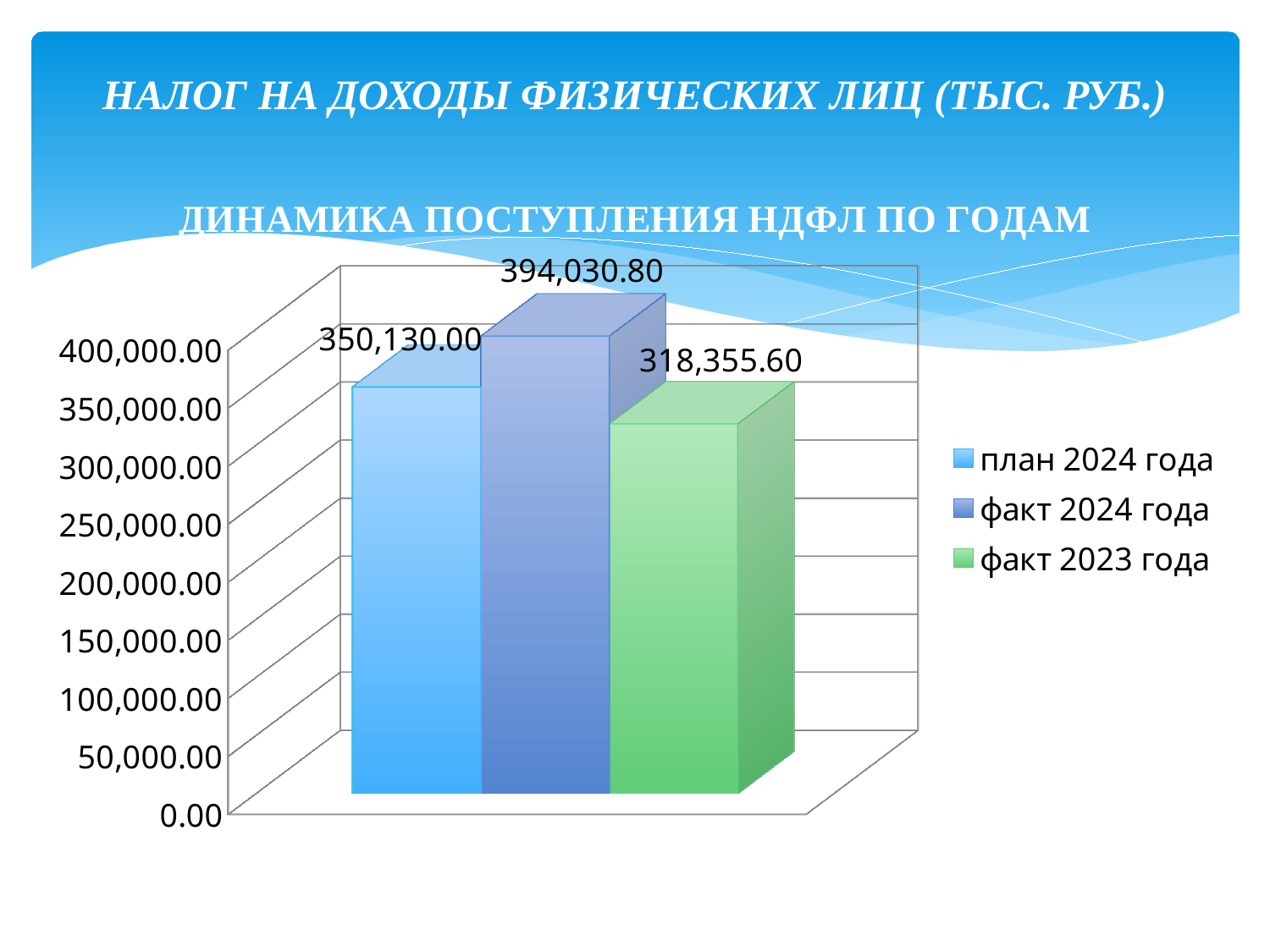
What is the difference between факт 2024 года and план 2024 года? 43,900.80 What is the value for факт 2023 года? 318,355.60 What is the value for план 2024 года? 350,130.00 What kind of chart is shown on the slide? bar chart Which series has the highest value? факт 2024 года Which series has the lowest value? факт 2023 года Is the value for факт 2023 года greater or less than 300,000.00? greater What is the difference between факт 2024 года and факт 2023 года? 75,675.20 Which is larger, план 2024 года or факт 2023 года? план 2024 года What is the title of the chart? ДИНАМИКА ПОСТУПЛЕНИЯ НДФЛ ПО ГОДАМ What is the value for факт 2024 года? 394,030.80 How many series does the legend list? 3